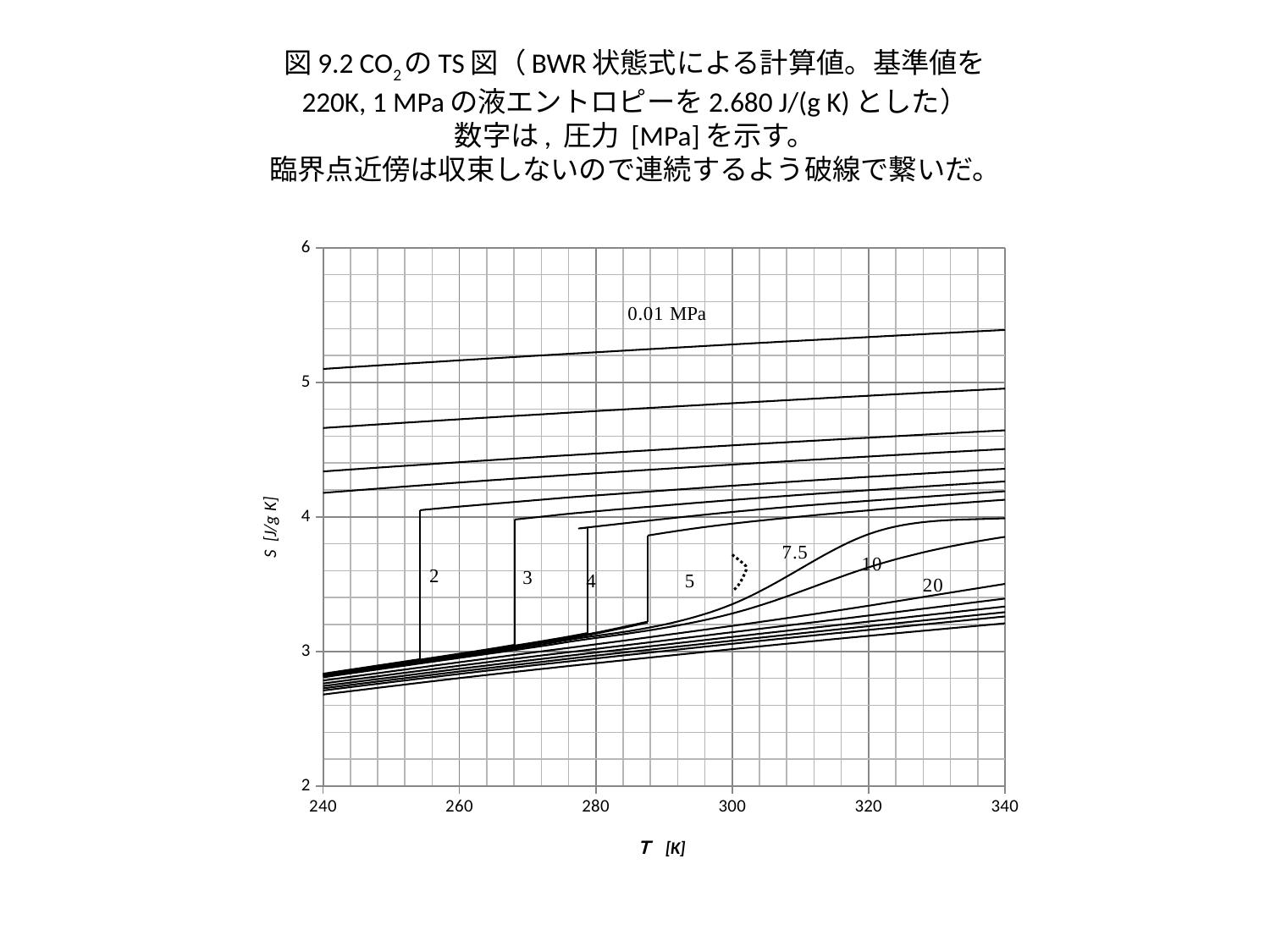
What is the label of the vertical axis of the chart? S [J/g K] Is the value of S for the 2 MPa curve at T = 240 K greater or less than 3? less How many pressure values are labelled on the curves in the chart? 8 Is the value of S for the 0.01 MPa curve at T = 240 K greater or less than 5? greater At T = 320 K, which curve has the higher entropy S: the 7.5 MPa curve or the 20 MPa curve? 7.5 MPa Is the value of S for the 20 MPa curve at T = 340 K greater or less than 4? less What kind of chart is shown on the slide? line chart Does the entropy S along the 0.01 MPa curve rise or fall as temperature T increases from 240 K to 340 K? rise At T = 340 K, which curve has the higher entropy S: the 0.01 MPa curve or the 20 MPa curve? 0.01 MPa What is the label of the horizontal axis of the chart? T [K]